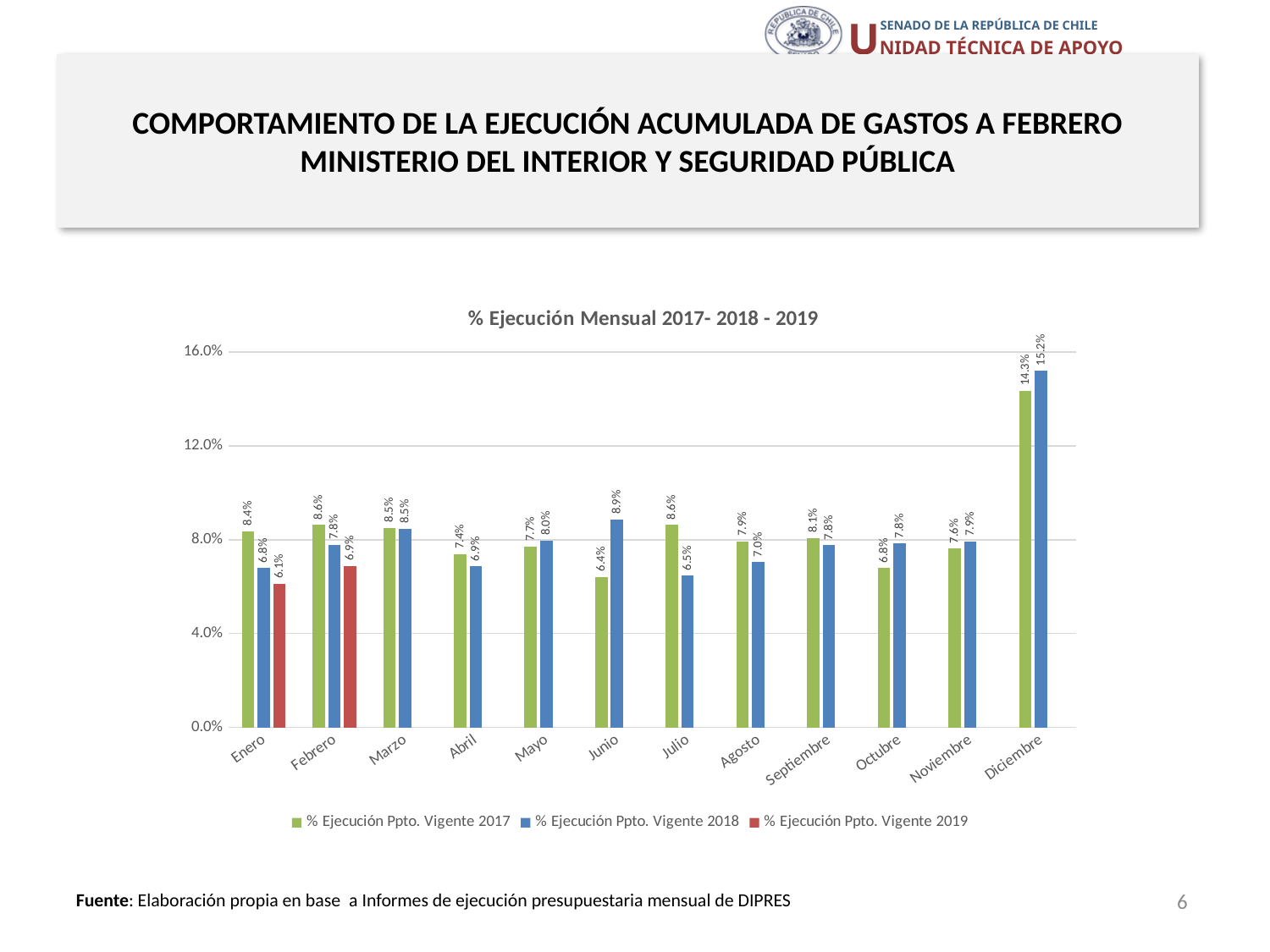
What is the difference between the 2018 and 2017 values in Diciembre? 0.9% In Julio, which series is larger: % Ejecución Ppto. Vigente 2017 or % Ejecución Ppto. Vigente 2018? % Ejecución Ppto. Vigente 2017 How many series does the legend list? 3 Is the value for % Ejecución Ppto. Vigente 2018 in Diciembre greater or less than 12.0%? greater What is the value for % Ejecución Ppto. Vigente 2019 in Enero? 6.1% What is the value for % Ejecución Ppto. Vigente 2017 in Diciembre? 14.3% What is the value for % Ejecución Ppto. Vigente 2018 in Junio? 8.9% Which month has the lowest value for % Ejecución Ppto. Vigente 2017? Junio What kind of chart is shown on the slide? Bar chart Which month has the highest value for % Ejecución Ppto. Vigente 2018? Diciembre How many months are shown on the x axis? 12 What is the title of the chart? % Ejecución Mensual 2017- 2018 - 2019